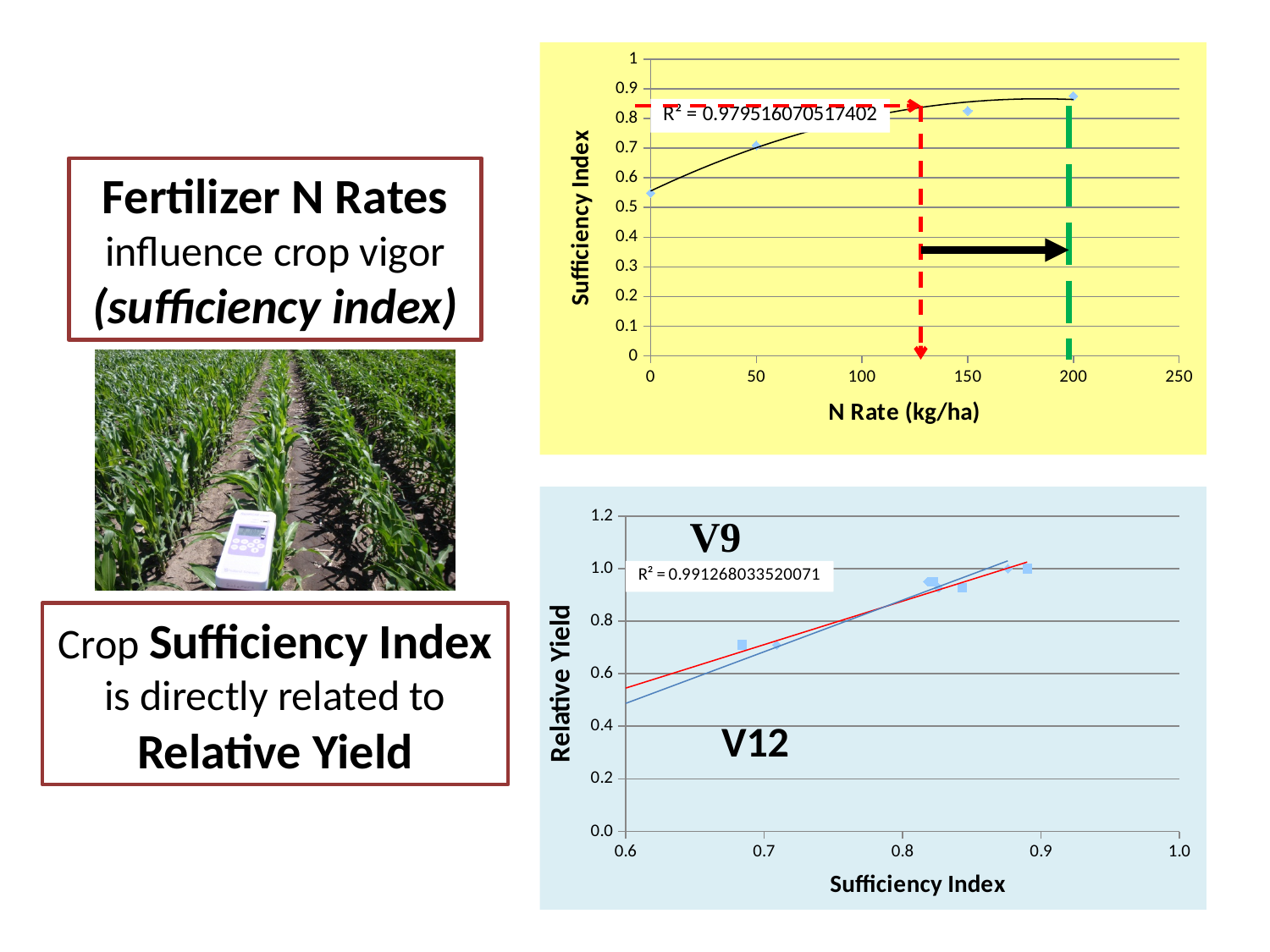
What kind of chart is the top chart (Sufficiency Index vs N Rate)? scatter chart In the top chart, what is the x-axis title? N Rate (kg/ha) In the top chart, does the sufficiency index rise or fall as the N rate increases? rise In the top chart, what is the R² value shown? R² = 0.979516070517402 In the top chart, is the sufficiency index at an N rate of 50 greater or less than 0.6? greater In the top chart, is the sufficiency index at an N rate of 0 greater or less than 0.6? less In the top chart, at which N rate is the sufficiency index highest? 200 In the top chart, is the sufficiency index at an N rate of 200 greater or less than 0.8? greater In the bottom chart, what is the y-axis title? Relative Yield In the bottom chart, what is the R² value shown? R² = 0.991268033520071 What kind of chart is the bottom chart (Relative Yield vs Sufficiency Index)? scatter chart In the bottom chart, does relative yield rise or fall as the sufficiency index increases? rise